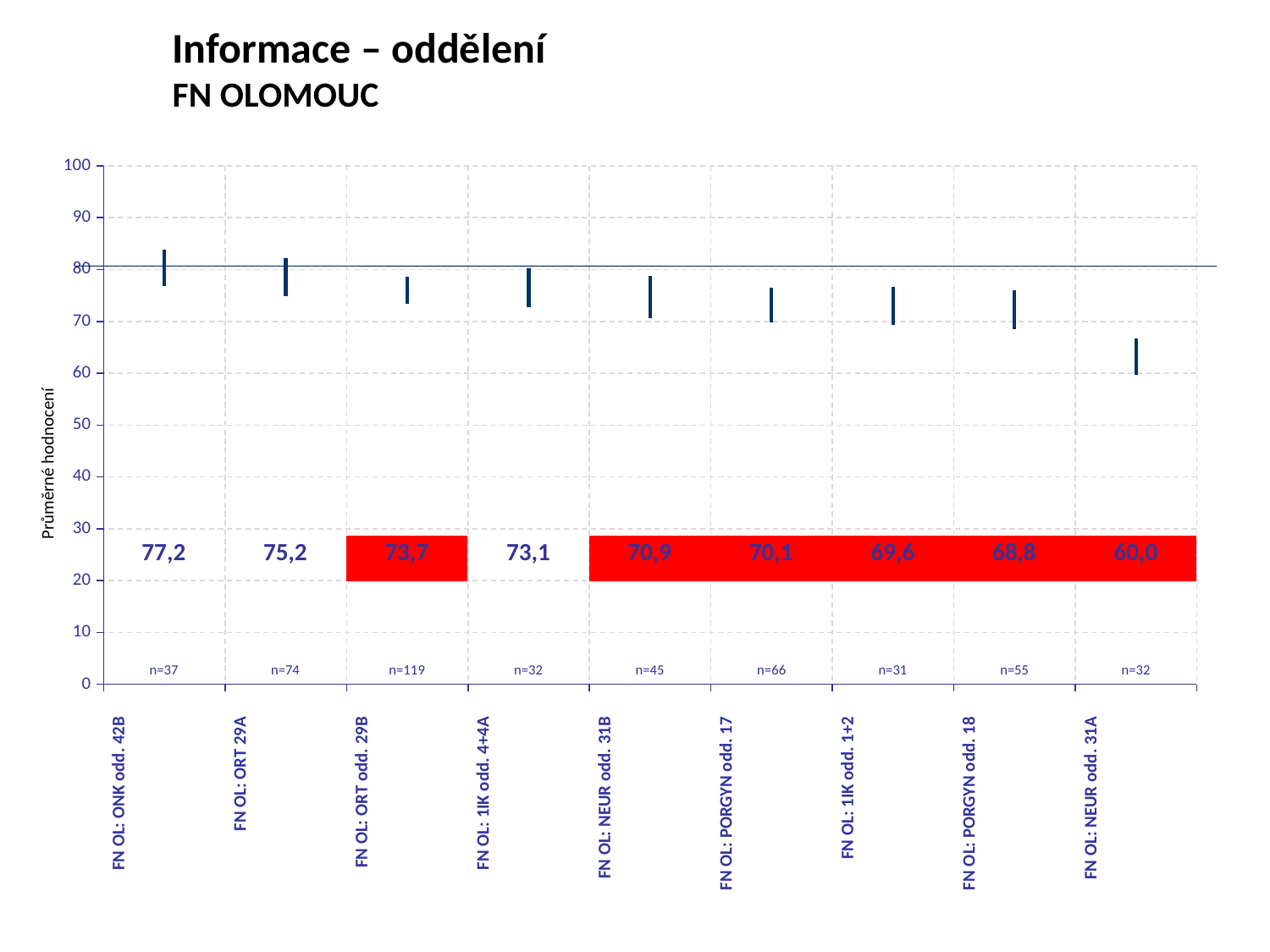
Which department has the highest average rating? FN OL: ONK odd. 42B Do the average ratings rise or fall from left to right across the departments? fall Which has a higher average rating, FN OL: ORT 29A or FN OL: 1IK odd. 4+4A? FN OL: ORT 29A What is the average rating for FN OL: NEUR odd. 31A? 60,0 What is the label of the vertical axis? Průměrné hodnocení Which department has the lowest average rating? FN OL: NEUR odd. 31A What is the sample size (n) for FN OL: ORT odd. 29B? n=119 How many departments are shown on the chart? 9 What is the difference between the average ratings of FN OL: ONK odd. 42B and FN OL: NEUR odd. 31A? 17,2 What is the subtitle of the chart below 'Informace – oddělení'? FN OLOMOUC What is the average rating (průměrné hodnocení) for FN OL: ONK odd. 42B? 77,2 What is the average rating for FN OL: PORGYN odd. 17? 70,1